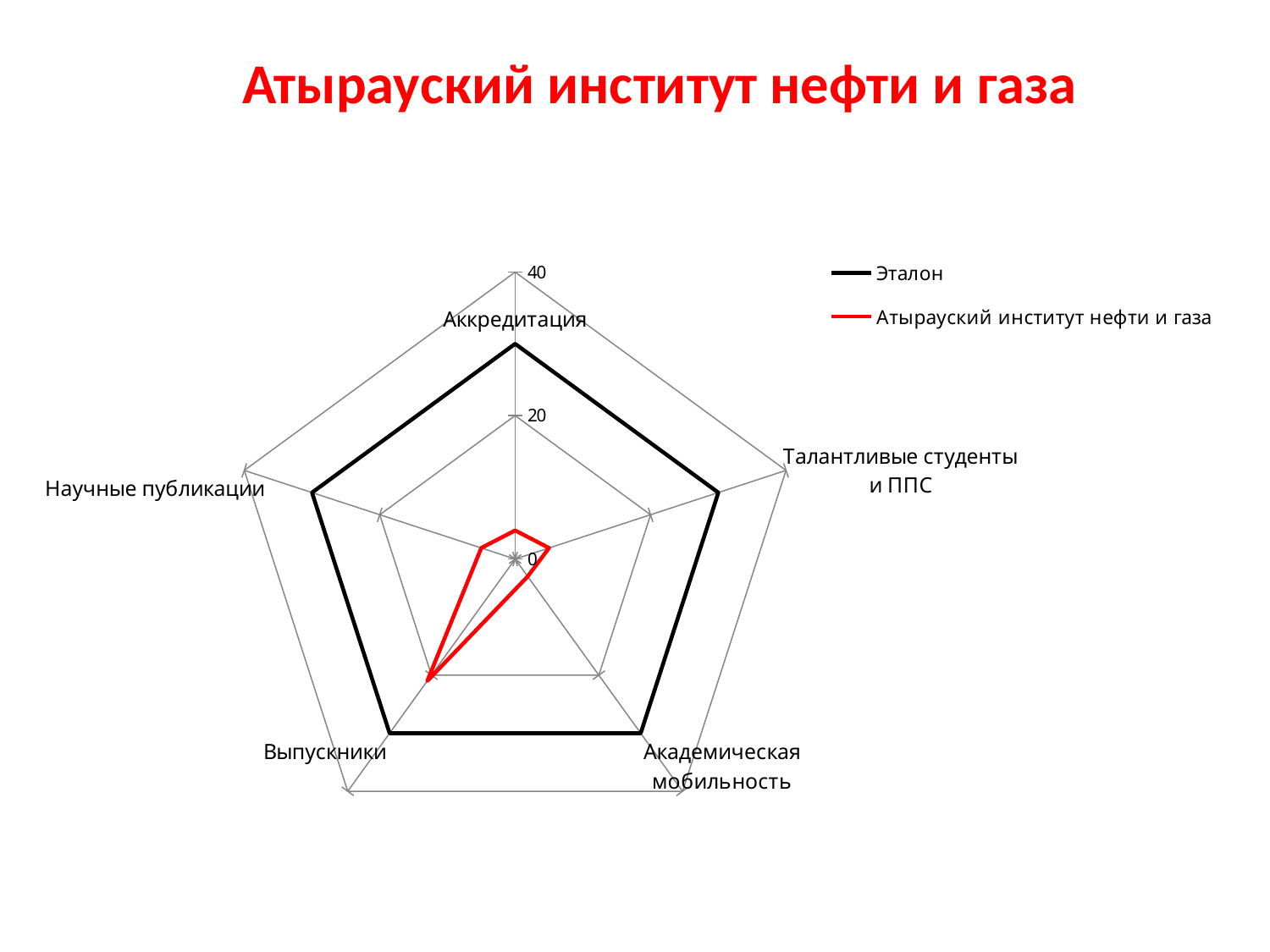
For which category does Атырауский институт нефти и газа have its highest value? Выпускники Is the value of Эталон for Аккредитация greater or less than 20? greater Which series is drawn in black? Эталон How many series does the legend list? 2 How many categories (axes) does the radar chart have? 5 What kind of chart is shown on the slide? Radar chart Is the value of Атырауский институт нефти и газа for Аккредитация greater or less than 20? less Is the value of Эталон for Выпускники greater or less than 40? less Which series has the larger value for Академическая мобильность, Эталон or Атырауский институт нефти и газа? Эталон Which series has the larger value for Научные публикации, Эталон or Атырауский институт нефти и газа? Эталон Which series is drawn in red? Атырауский институт нефти и газа